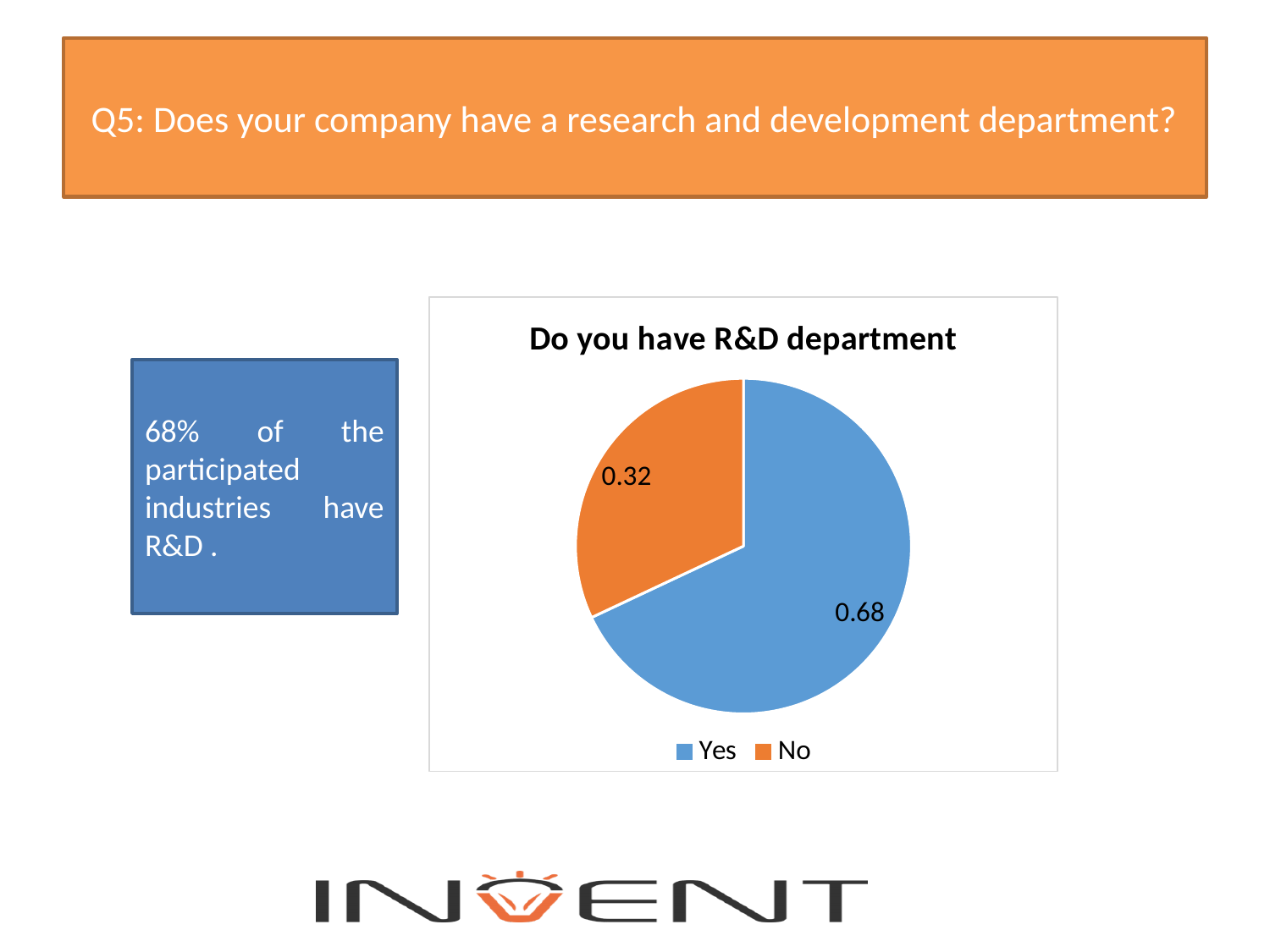
What colour is the Yes slice? blue Which slice is the smallest? No How many entries does the legend list? 2 What is the value shown for the Yes slice? 0.68 Which is larger, the Yes slice or the No slice? Yes What is the value shown for the No slice? 0.32 What is the total of the two slice values? 1 What is the difference between the Yes value and the No value? 0.36 Which slice is the largest? Yes What is the title of the chart? Do you have R&D department How many slices does the pie chart have? 2 What kind of chart is shown on the slide? pie chart